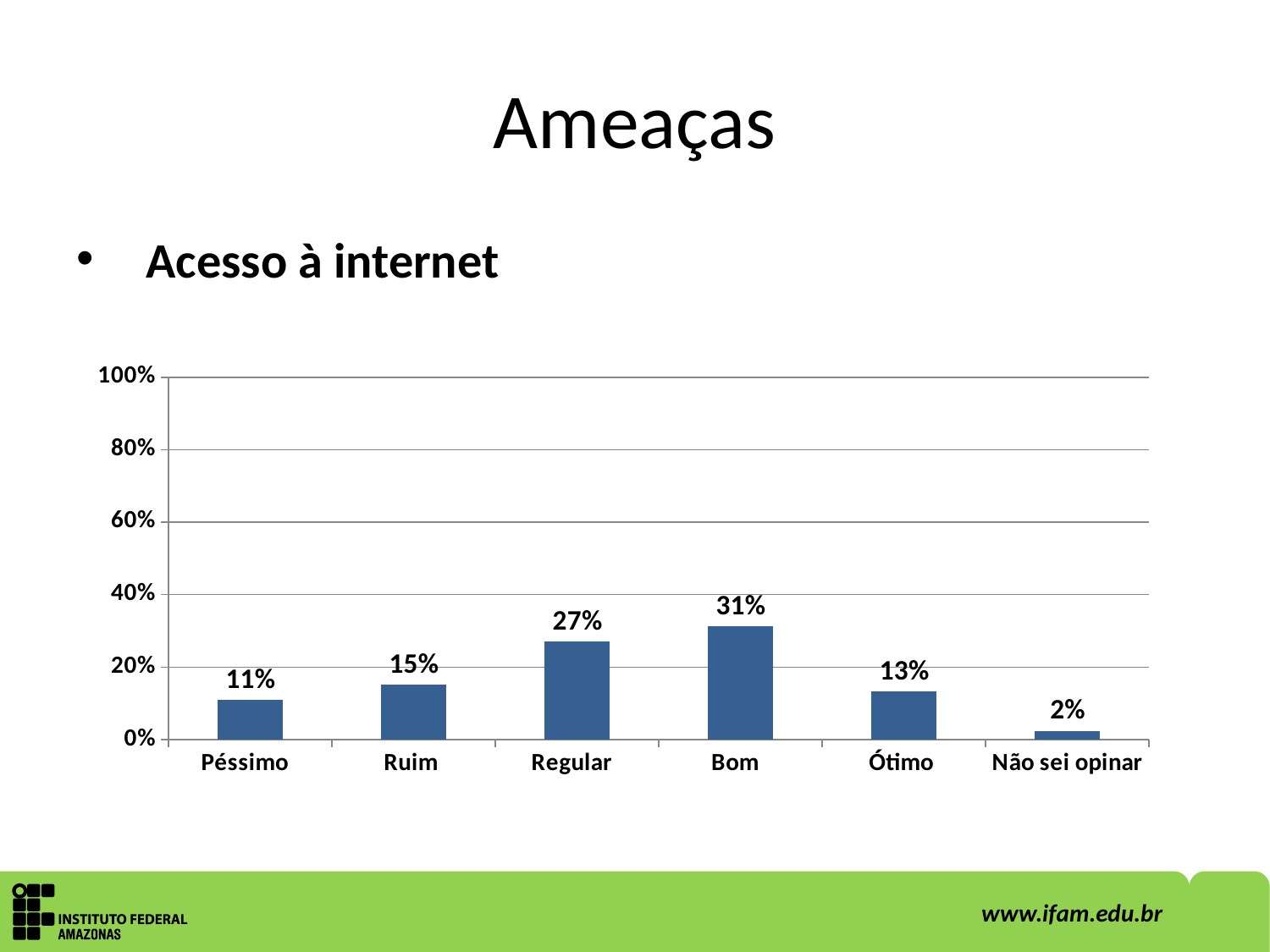
What is the difference between the values for Ruim and Ótimo? 2% What is the value for Péssimo? 11% What is the value for Não sei opinar? 2% Is the value for Bom greater or less than 40%? less How many categories are shown on the x axis? 6 What kind of chart is shown on the slide? bar chart Which is larger, the value for Ruim or the value for Ótimo? Ruim Which category has the highest value? Bom What is the difference between the values for Bom and Regular? 4% Which category has the lowest value? Não sei opinar What is the value for Regular? 27% What is the bullet text above the chart? Acesso à internet